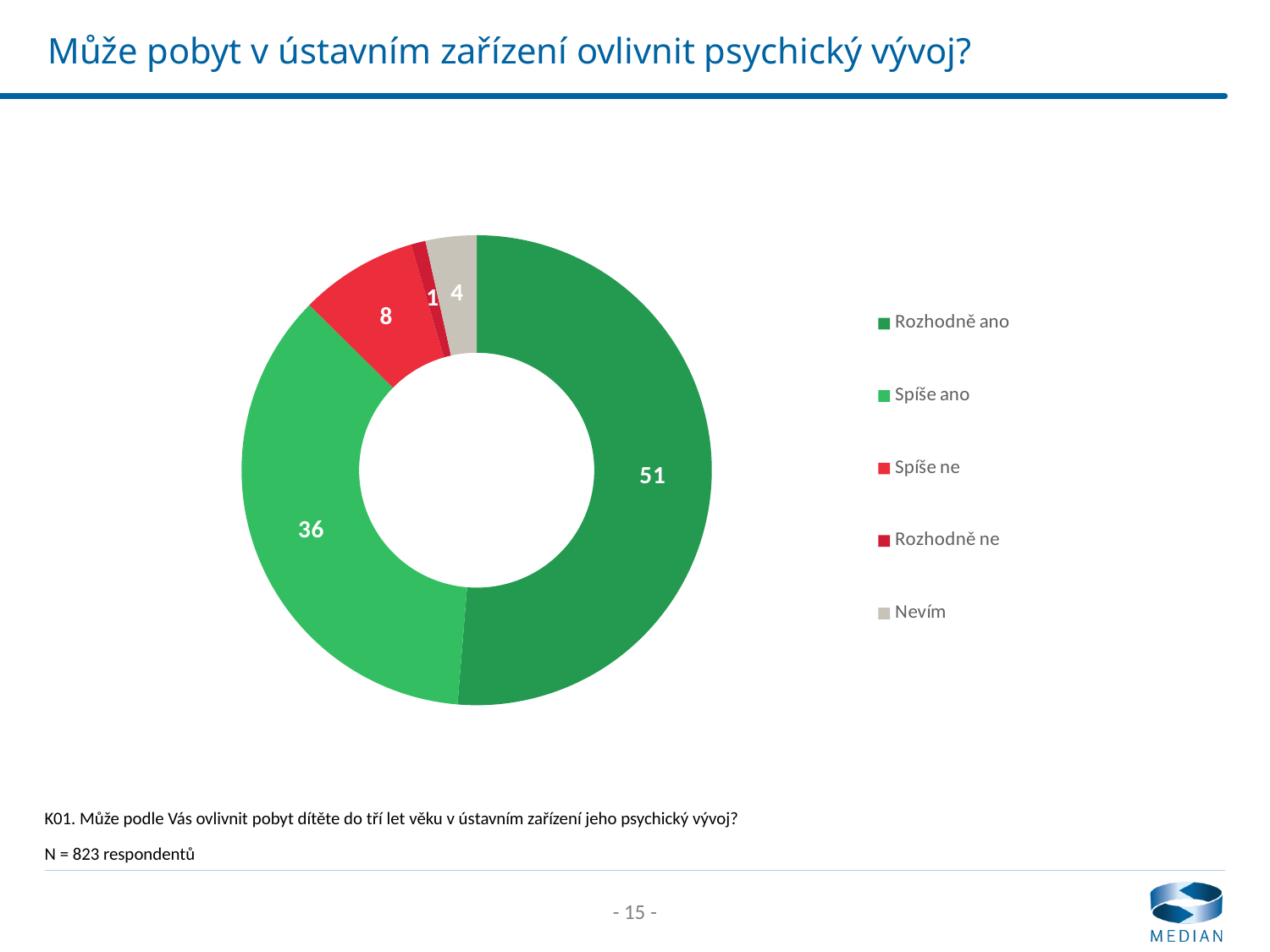
How many categories does the chart show? 5 What value is shown for "Nevím"? 4 What kind of chart is shown on the slide? Doughnut chart Which category has the highest value? Rozhodně ano What value is shown for "Rozhodně ano"? 51 What colour is the "Nevím" segment? Grey What is the combined value of "Rozhodně ano" and "Spíše ano"? 87 Which category has the lowest value? Rozhodně ne Which is larger, the value for "Spíše ne" or the value for "Nevím"? Spíše ne What is the difference between the values for "Rozhodně ano" and "Spíše ano"? 15 What value is shown for "Spíše ne"? 8 What value is shown for "Spíše ano"? 36